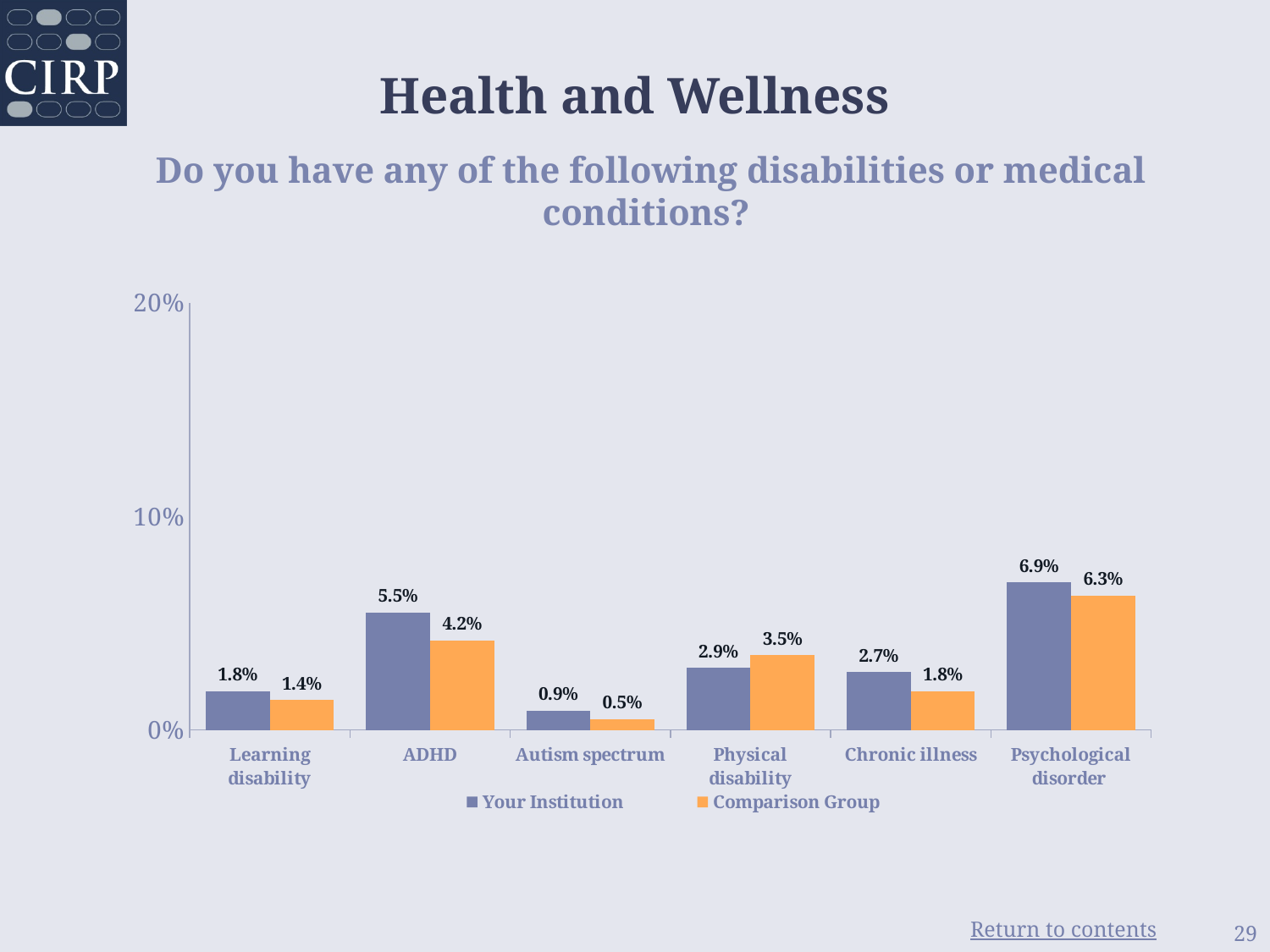
What is the value for Your Institution for ADHD? 5.5% Is the value for Your Institution for Psychological disorder greater or less than 10%? less How many categories are shown on the x axis? 6 For Physical disability, which is larger: Your Institution or the Comparison Group? Comparison Group Which category has the highest value for Your Institution? Psychological disorder What is the difference between Your Institution and the Comparison Group for ADHD? 1.3% What kind of chart is shown on the slide? bar chart Which category has the lowest value for the Comparison Group? Autism spectrum What is the difference between Your Institution and the Comparison Group for Chronic illness? 0.9% What is the value for Your Institution for Chronic illness? 2.7% How many series does the legend list? 2 What is the value for the Comparison Group for Physical disability? 3.5%